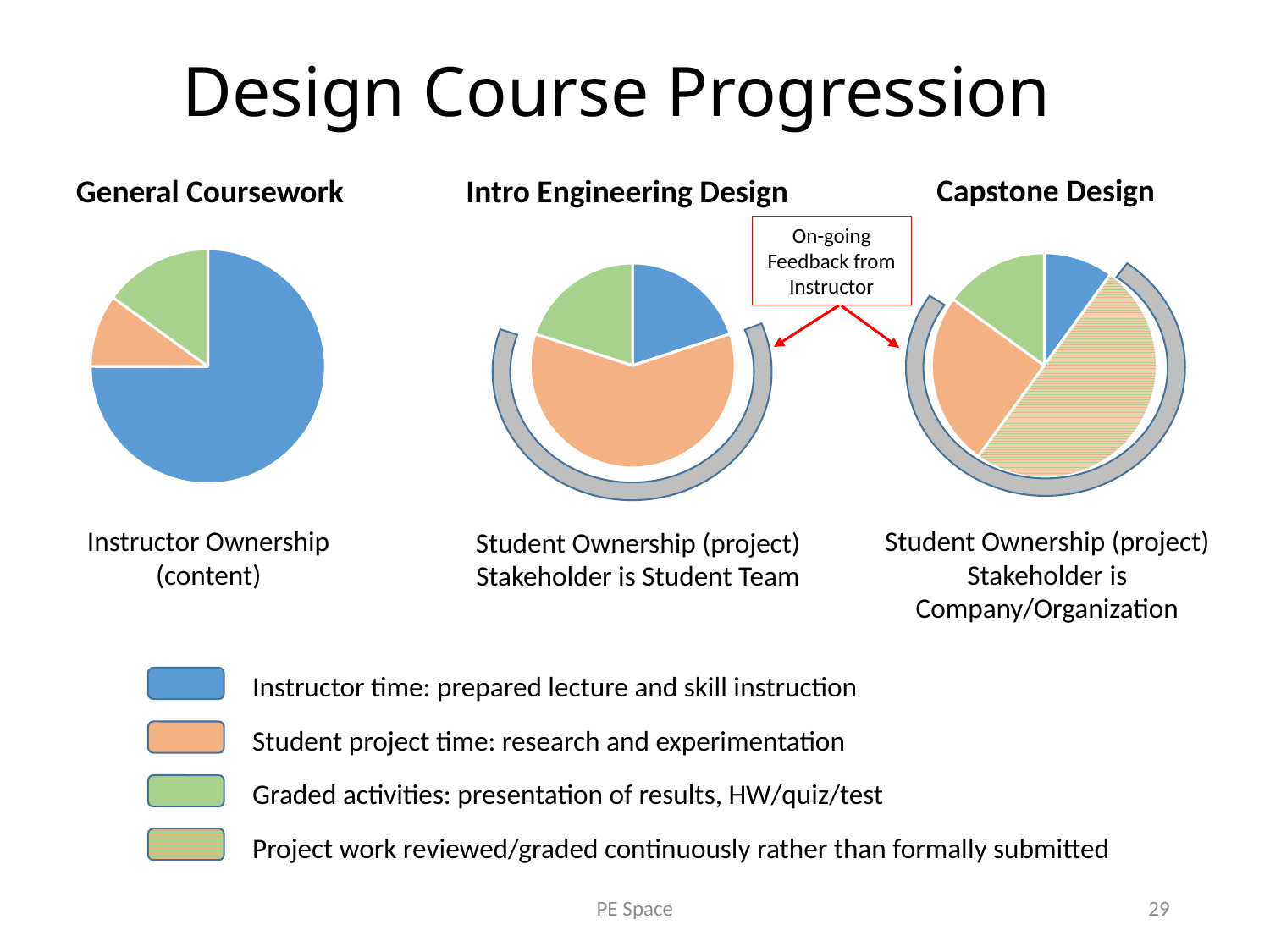
In the General Coursework pie chart, which slice is larger: instructor time or student project time? Instructor time How many slices does the General Coursework pie chart have? 3 Which colour represents graded activities in the pie charts? Green In the Intro Engineering Design pie chart, which category takes the largest slice? Student project time: research and experimentation In the Capstone Design pie chart, which slice is larger: the hatched project-work slice or the student project time slice? The hatched project-work slice How many categories does the legend at the bottom of the slide list? 4 In the Capstone Design pie chart, which category takes the largest slice? Project work reviewed/graded continuously rather than formally submitted What kind of chart is used under the heading General Coursework? Pie chart In the Intro Engineering Design pie chart, which slice is larger: student project time or instructor time? Student project time What is the title of the pie chart on the right of the slide? Capstone Design In the General Coursework pie chart, which category takes the largest slice? Instructor time: prepared lecture and skill instruction How many slices does the Capstone Design pie chart have? 4